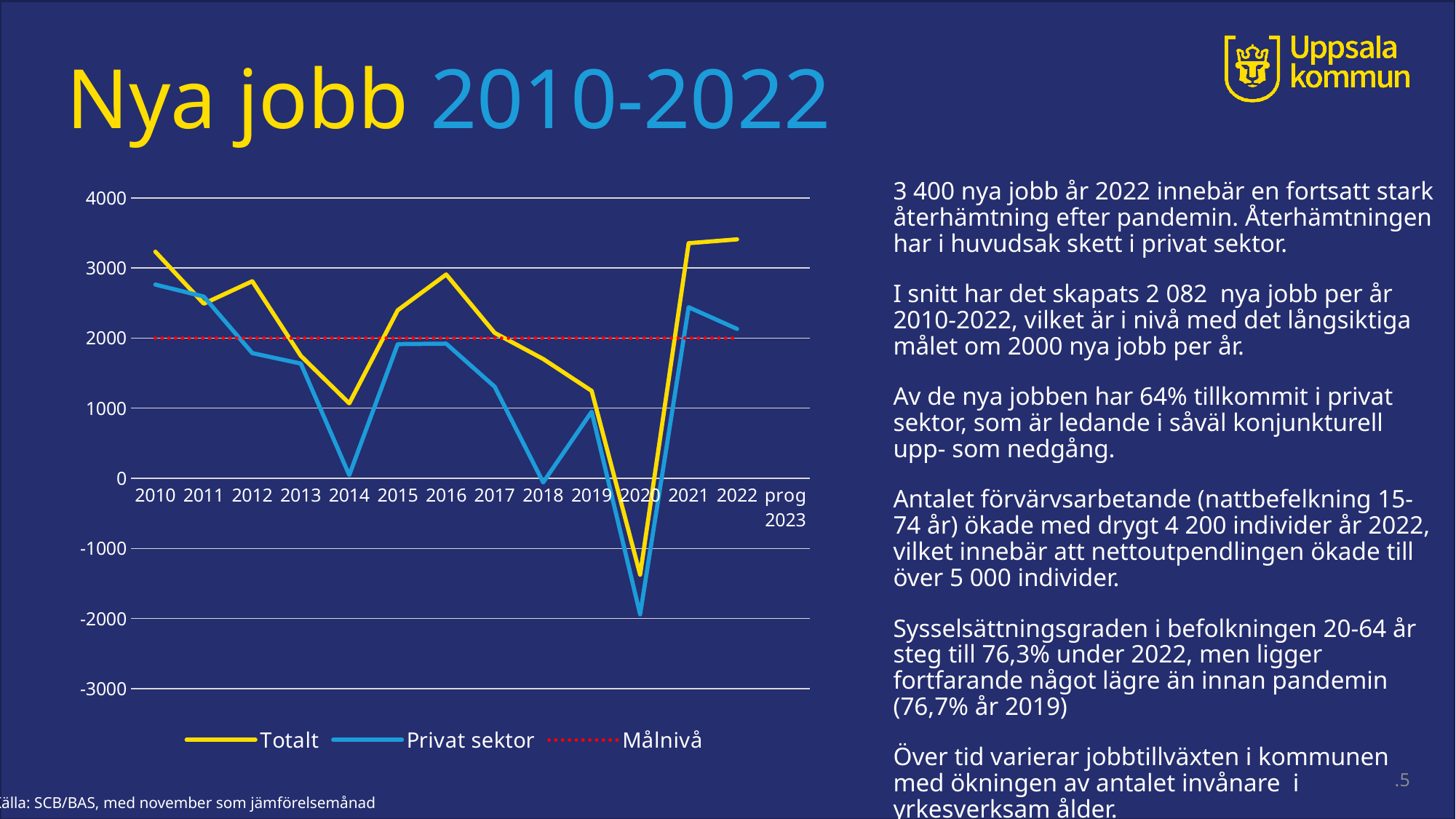
In which year is the Privat sektor series at its lowest? 2020 How many series does the chart legend list? 3 What is the title of the slide containing the chart? Nya jobb 2010-2022 Is the value for Totalt in 2020 greater or less than -1000? less In 2021, which series has the higher value, Totalt or Privat sektor? Totalt What kind of chart is shown on the slide? line chart Is the value for Totalt in 2022 greater or less than 3000? greater Does the Totalt series rise or fall from 2016 to 2020? fall In which year is the Totalt series at its lowest? 2020 Is the value for Privat sektor in 2010 greater or less than 2000? greater Which series is drawn as a red dotted line in the chart? Målnivå